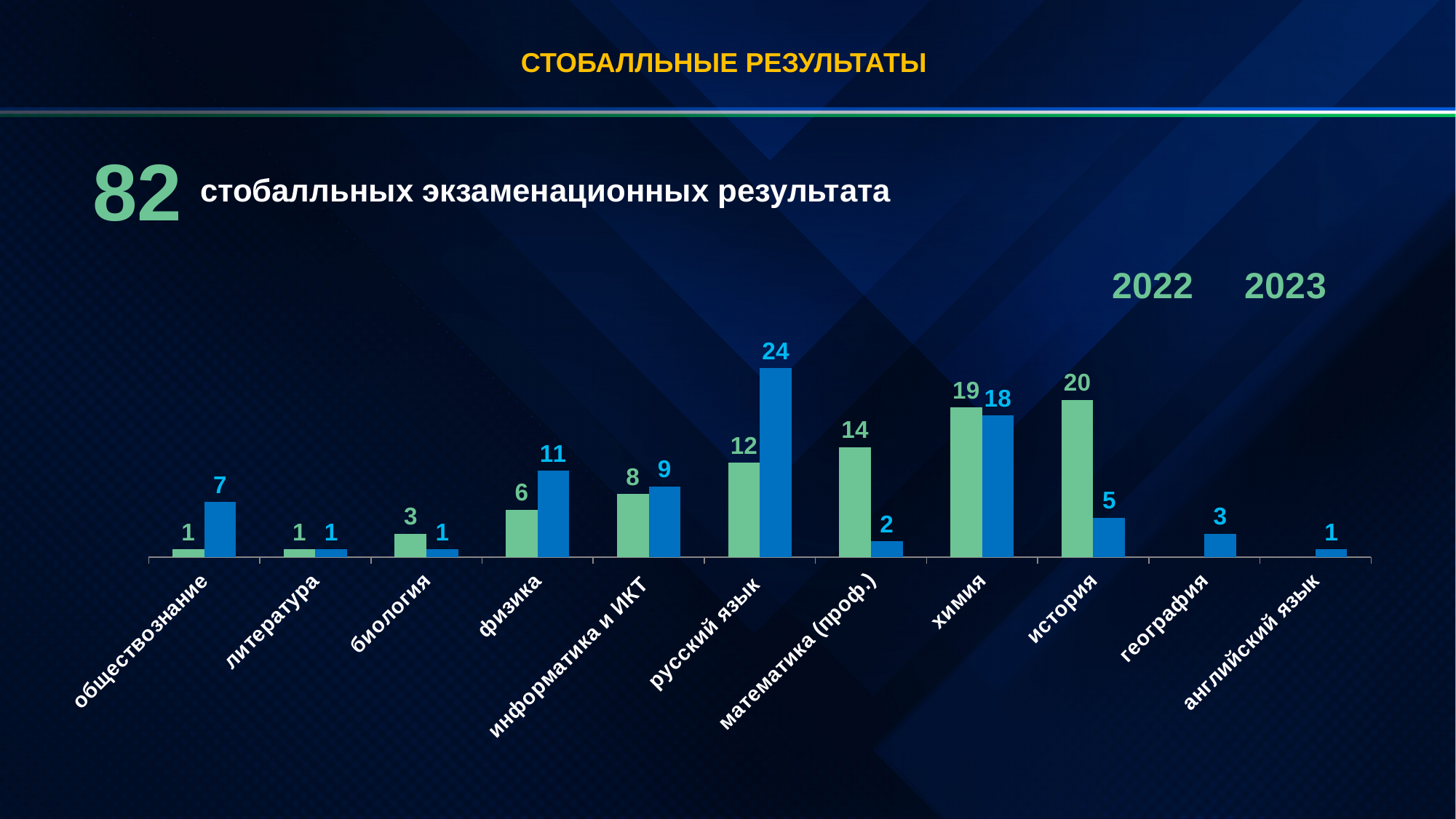
What is the difference between the 2023 and 2022 values for русский язык? 12 What is the 2022 value for математика (проф.)? 14 How many series does the chart's legend list? 2 What is the 2022 value for химия? 19 Which category has the highest 2022 value? история What type of chart is shown on the slide? bar chart What is the 2023 value for физика? 11 What is the 2023 value for русский язык? 24 What is the difference between the 2022 and 2023 values for математика (проф.)? 12 How many categories are shown on the x axis of the chart? 11 Which category has the highest 2023 value? русский язык Which is larger for история: the 2022 value or the 2023 value? 2022